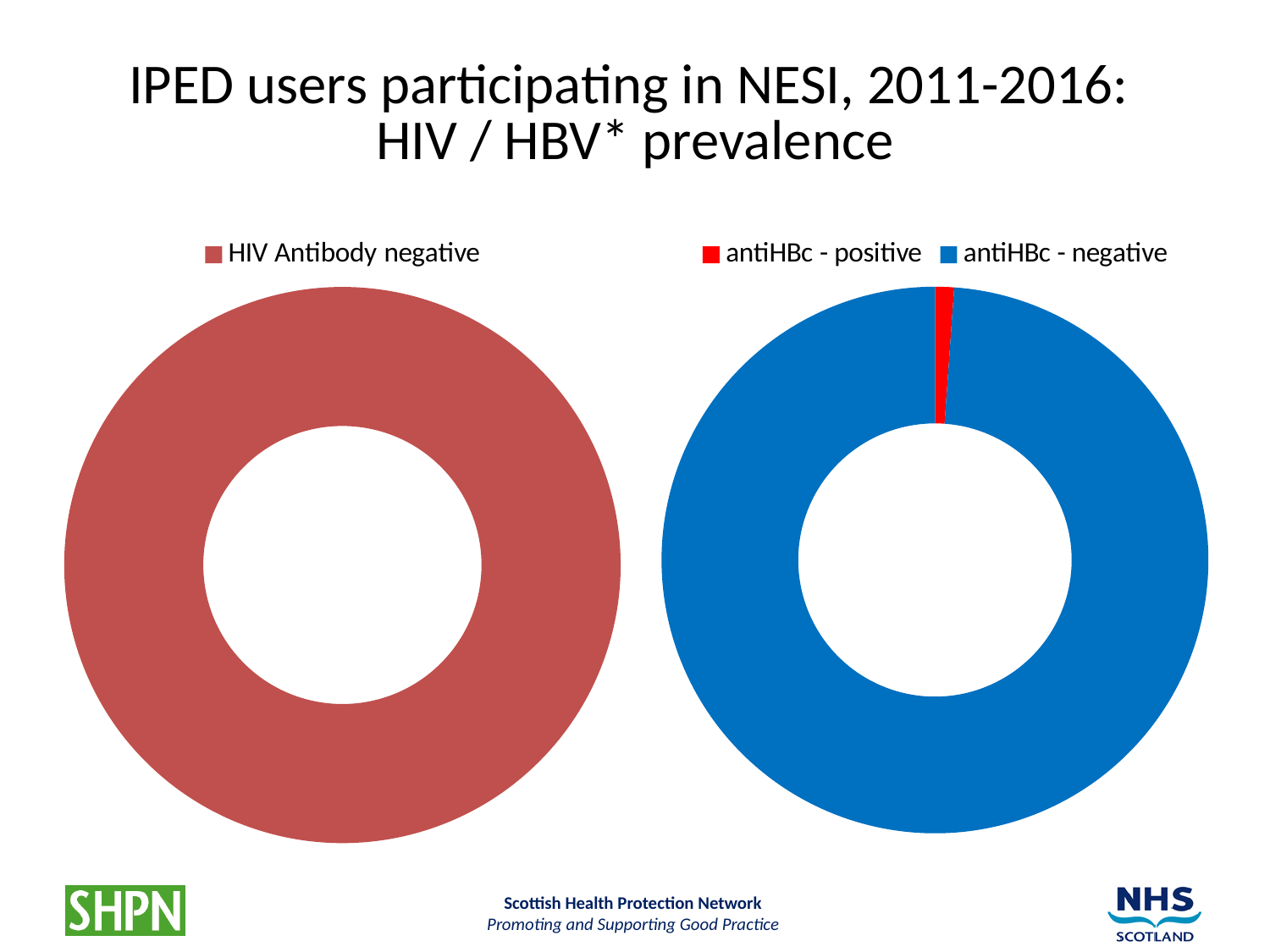
What kind of chart is the right chart on the slide? Doughnut chart How many entries does the legend of the left chart list? 1 In the right chart, which category has the smallest slice? antiHBc - positive In the right chart, which is larger: antiHBc - positive or antiHBc - negative? antiHBc - negative How many charts are shown on the slide? 2 In the right chart, which category has the largest slice? antiHBc - negative What is the only category shown in the legend of the left chart? HIV Antibody negative In the right chart, what colour represents antiHBc - positive? Red How many entries does the legend of the right chart list? 2 What kind of chart is the left chart on the slide? Doughnut chart